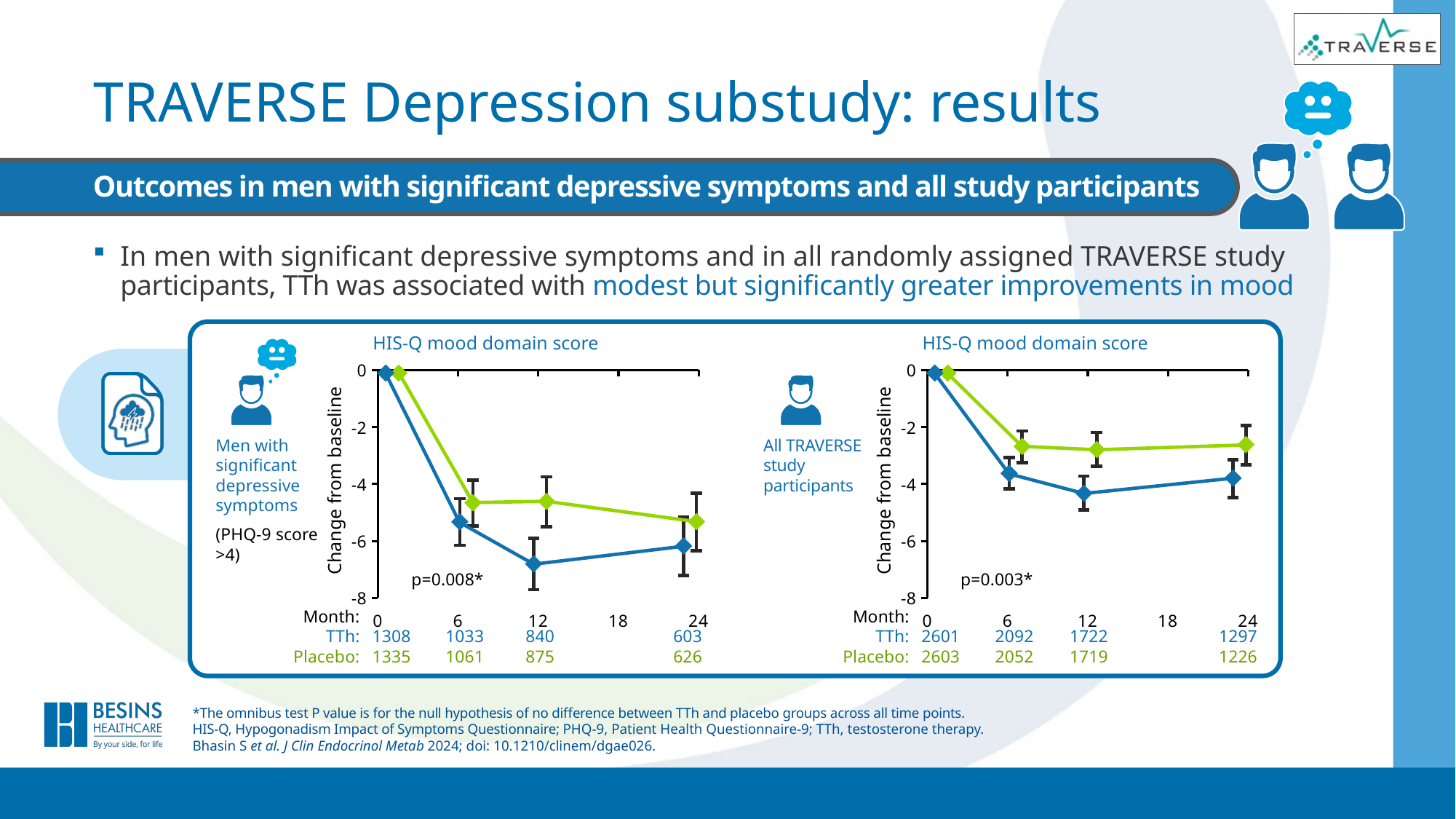
In the left chart (men with significant depressive symptoms), how many placebo participants are listed at month 24? 626 In the left chart (men with significant depressive symptoms), what is the difference between the placebo and TTh participant counts at month 0? 27 How many time points with participant counts are listed below each chart? 4 What kind of chart is used for the HIS-Q mood domain score in men with significant depressive symptoms (left chart)? Line chart In the right chart (all TRAVERSE study participants), how many placebo participants are listed at month 24? 1226 In the right chart (all TRAVERSE study participants), is the placebo change from baseline at month 24 greater or less than -4? greater In the right chart (all TRAVERSE study participants), by how much does the TTh participant count fall from month 6 to month 24? 795 In the left chart (men with significant depressive symptoms), how many TTh participants are listed at month 0? 1308 In the left chart (men with significant depressive symptoms), is the TTh change from baseline at month 12 greater or less than -6? less In the right chart (all TRAVERSE study participants), how many TTh participants are listed at month 12? 1722 What p-value is shown on the left chart (men with significant depressive symptoms)? p=0.008* In the right chart (all TRAVERSE study participants), which group shows the larger decrease from baseline at month 24, TTh or placebo? TTh